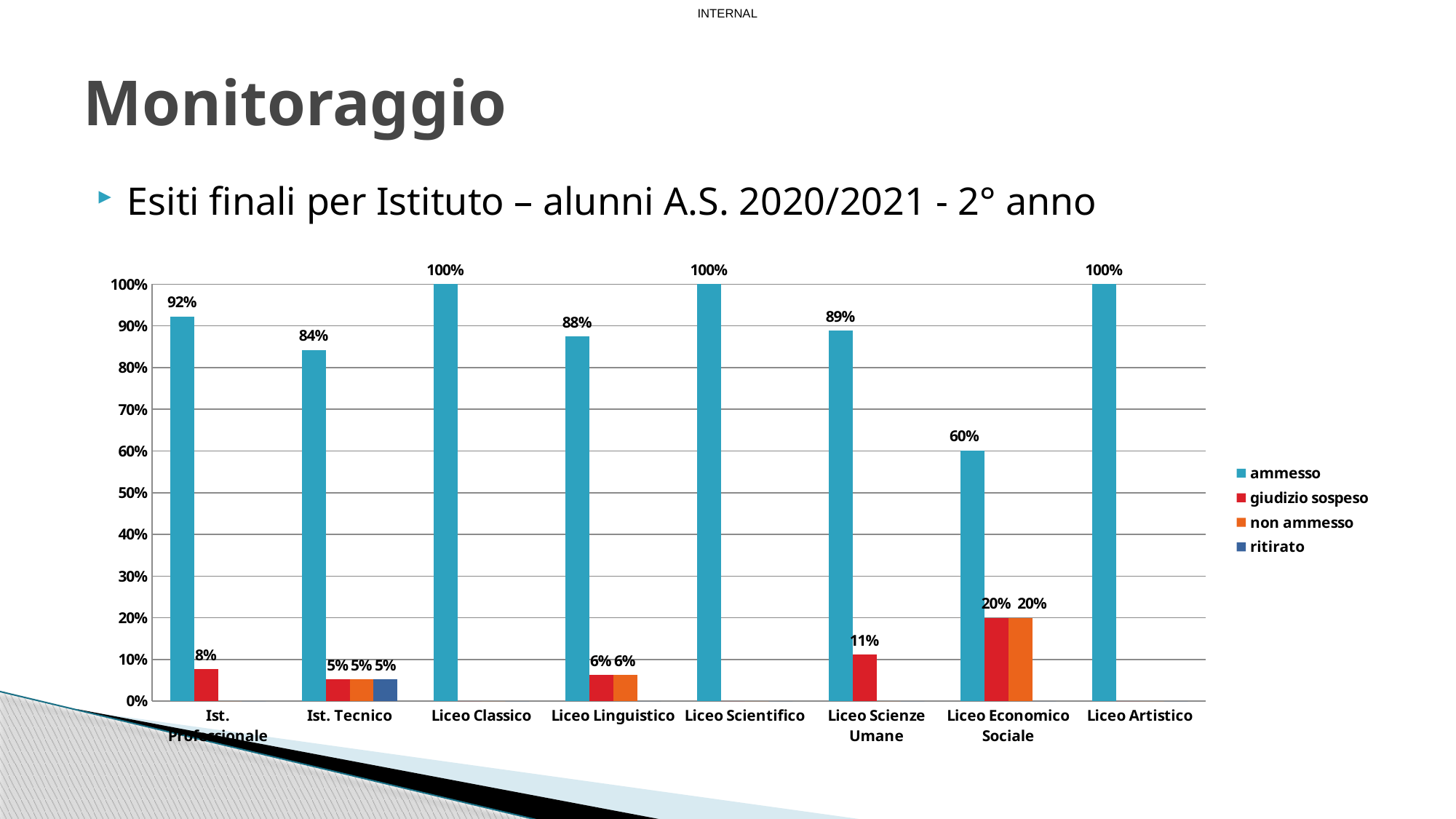
What is the 'ritirato' value for Ist. Tecnico? 5% How many series does the legend list? 4 What is the 'ammesso' value for Ist. Professionale? 92% What is the difference between the 'ammesso' values for Ist. Professionale and Ist. Tecnico? 8% What is the 'giudizio sospeso' value for Liceo Scienze Umane? 11% What type of chart is shown on the slide? bar chart What is the 'non ammesso' value for Liceo Economico Sociale? 20% Which is larger, the 'ammesso' value for Liceo Linguistico or for Liceo Scienze Umane? Liceo Scienze Umane How many institutes (categories) are shown on the x axis? 8 Which institutes have an 'ammesso' value of 100%? Liceo Classico, Liceo Scientifico, Liceo Artistico Which legend entry is shown in red? giudizio sospeso Which institute has the lowest 'ammesso' value? Liceo Economico Sociale